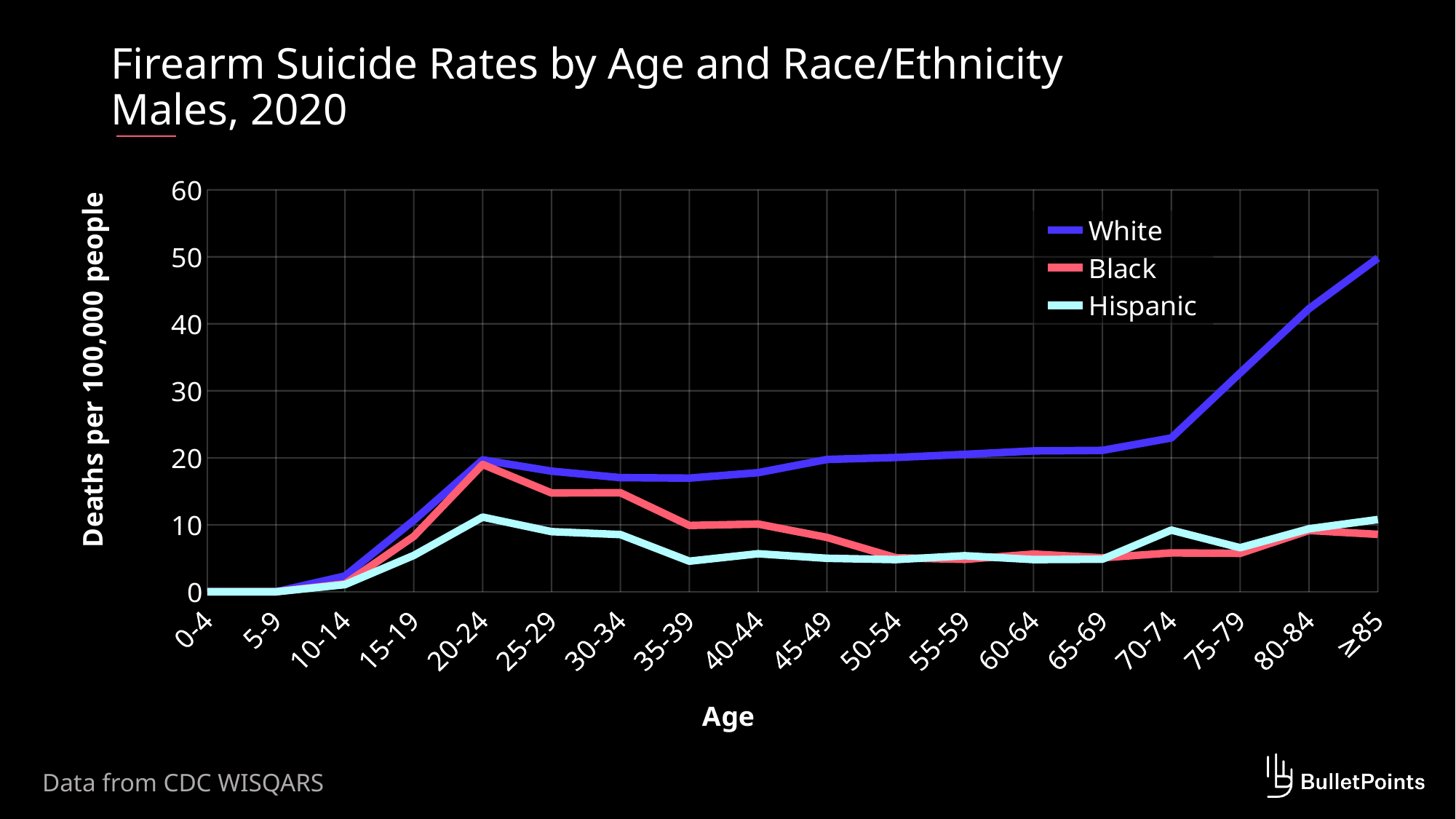
Does the White series rise or fall from 65-69 to ≥85? rise What kind of chart is shown on the slide? line chart For the White series, which age group has the highest value? ≥85 How many age groups are shown on the x axis? 18 What is the y-axis label of the chart? Deaths per 100,000 people Is the value for Hispanic at 35-39 greater or less than 10? less For the Black series, which age group has the highest value? 20-24 Is the value for White at 75-79 greater or less than 30? greater Which series is shown in blue in the legend? White How many series does the legend list? 3 Is the value for White at ≥85 greater or less than 40? greater At age 35-39, which series has the larger value, White or Black? White